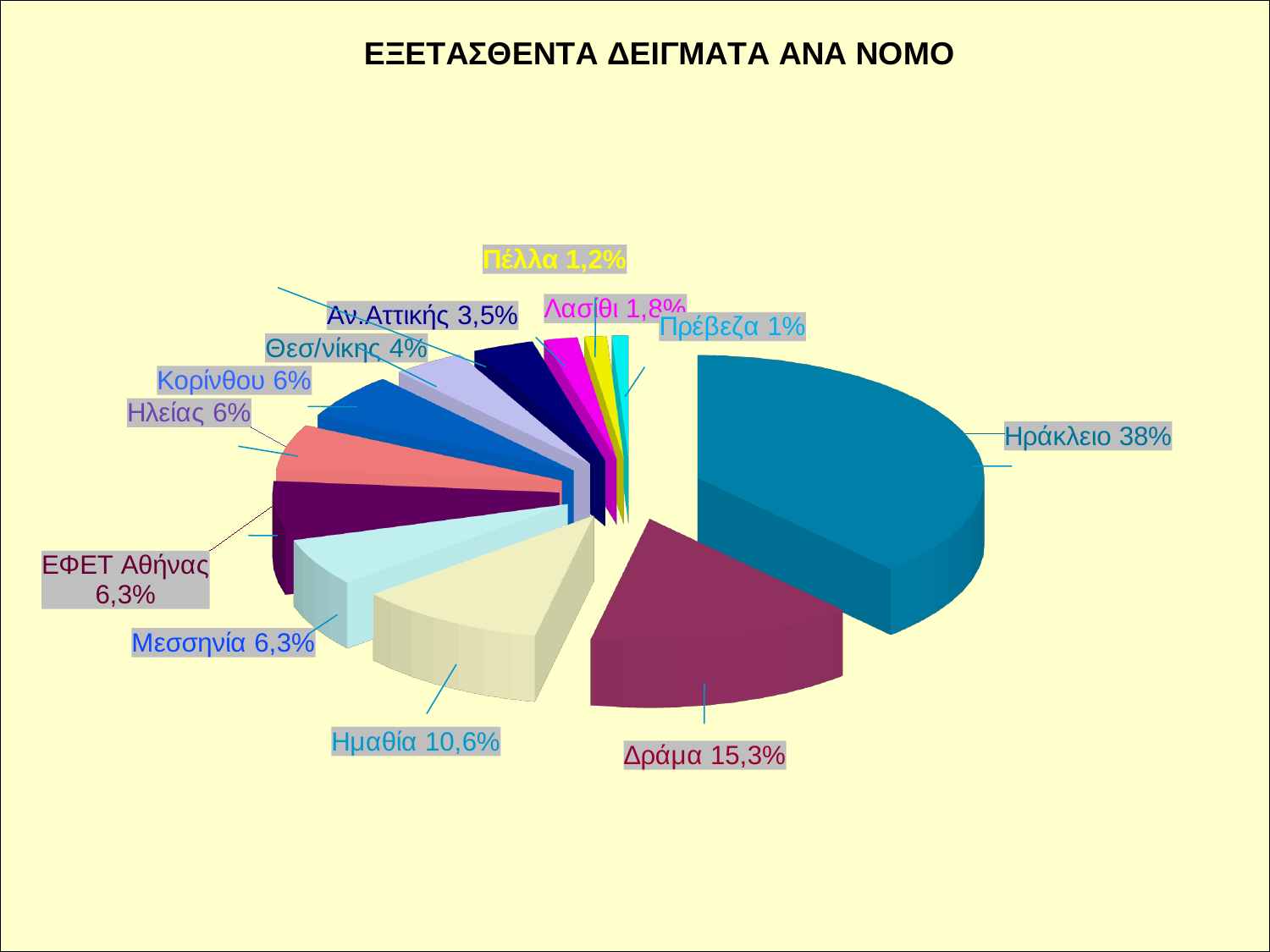
What kind of chart is shown on the slide? Pie chart What is the share for Δράμα? 15,3% What is the share for Πρέβεζα? 1% Which is larger, the share for Ημαθία or the share for Μεσσηνία? Ημαθία What is the share for Θεσ/νίκης? 4% What is the title of the chart? ΕΞΕΤΑΣΘΕΝΤΑ ΔΕΙΓΜΑΤΑ ΑΝΑ ΝΟΜΟ Which category has the largest slice of the pie? Ηράκλειο How many slices does the pie chart have? 12 What is the difference in percentage points between Ηράκλειο and Δράμα? 22,7 What is the share for Ημαθία? 10,6% Which category has the smallest slice of the pie? Πρέβεζα What is the share for Ηράκλειο? 38%